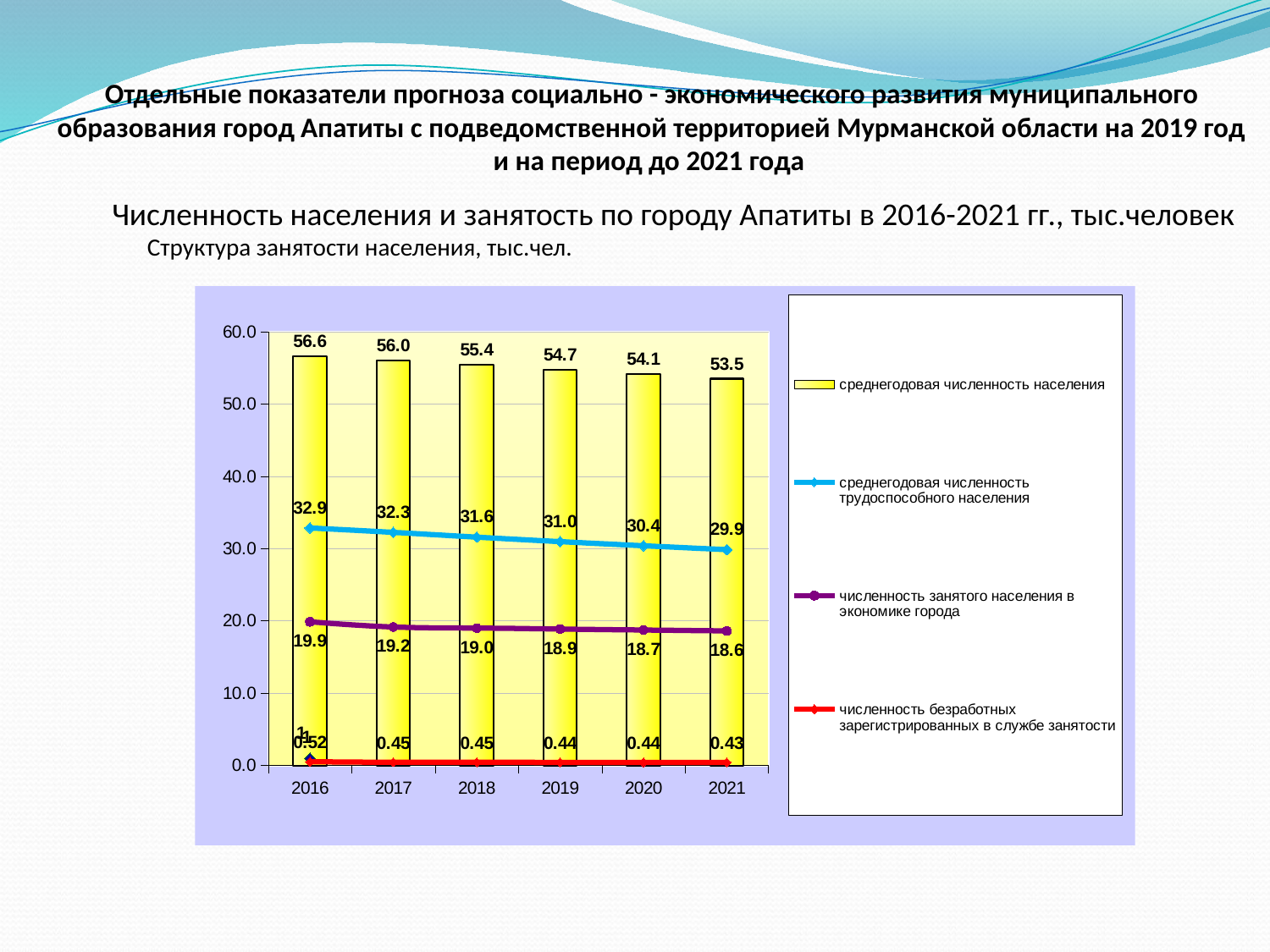
What is the value of численность безработных зарегистрированных в службе занятости in 2018? 0.45 What is the average annual population (среднегодовая численность населения) shown for 2016? 56.6 What is the value of среднегодовая численность трудоспособного населения in 2019? 31.0 How many years are shown on the x axis of the chart? 6 How many series does the chart legend list? 4 What is the difference between среднегодовая численность населения in 2016 and in 2021? 3.1 Which is larger: среднегодовая численность трудоспособного населения in 2017 or численность занятого населения в экономике города in 2017? среднегодовая численность трудоспособного населения Which series in the chart is drawn as yellow bars? среднегодовая численность населения What is the value of численность занятого населения в экономике города in 2021? 18.6 In which year is среднегодовая численность населения the lowest? 2021 In which year is среднегодовая численность трудоспособного населения the highest? 2016 Does среднегодовая численность населения rise or fall from 2016 to 2021? fall